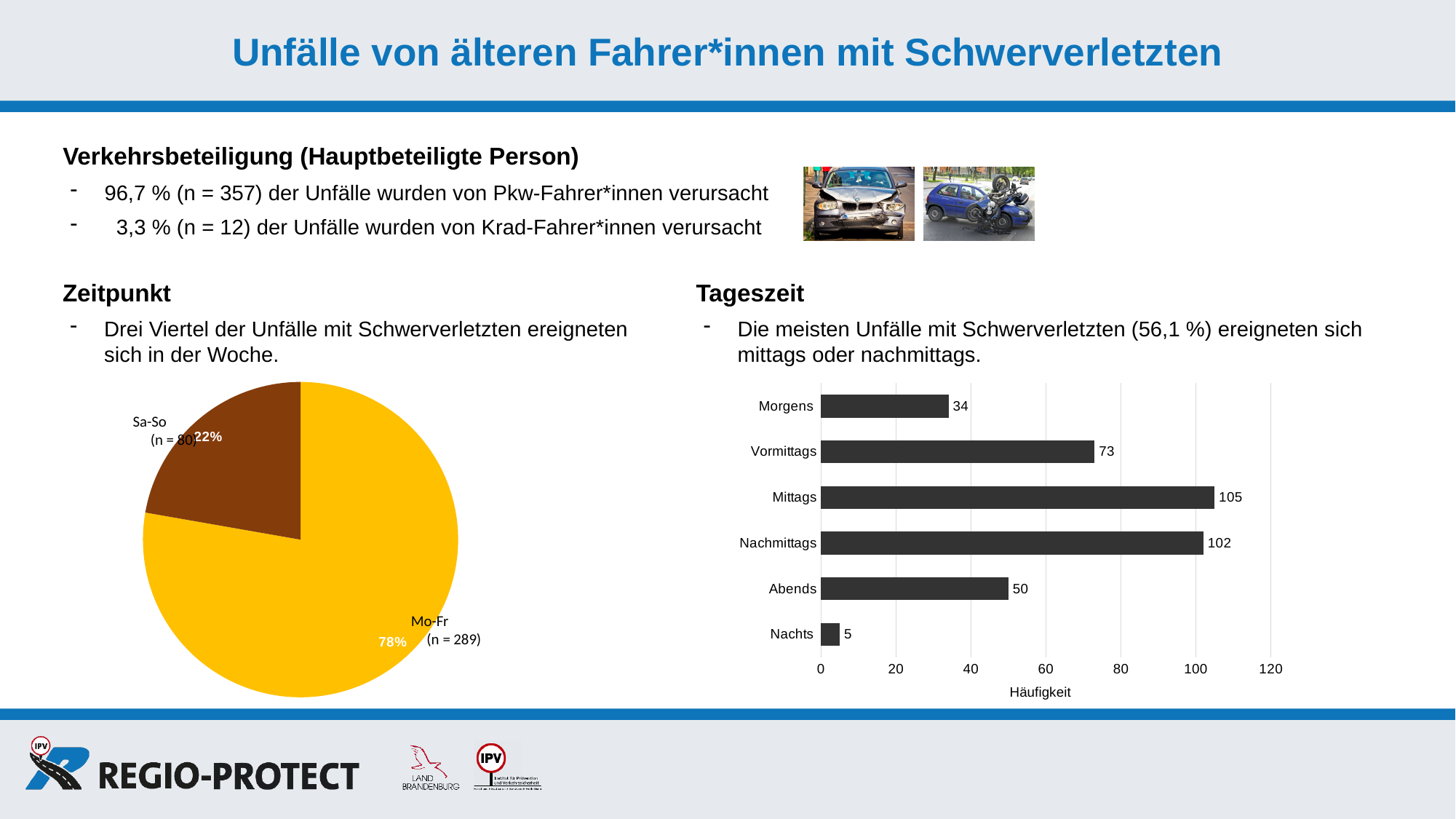
What is the x-axis label of the bar chart on the right (Tageszeit)? Häufigkeit How many categories are shown in the bar chart on the right (Tageszeit)? 6 In the bar chart on the right (Tageszeit), what is the value for Nachts? 5 In the pie chart on the left (Zeitpunkt), what share of accidents occurred Mo-Fr? 78% In the bar chart on the right (Tageszeit), which is larger, the value for Morgens or the value for Abends? Abends In the bar chart on the right (Tageszeit), what is the difference between the values for Nachmittags and Abends? 52 In the pie chart on the left (Zeitpunkt), what is the n value shown for Sa-So? n = 80 In the bar chart on the right (Tageszeit), what is the value for Vormittags? 73 What kind of chart is the chart on the right (Tageszeit)? Bar chart In the bar chart on the right (Tageszeit), which category has the highest value? Mittags In the bar chart on the right (Tageszeit), what is the value for Mittags? 105 In the bar chart on the right (Tageszeit), which category has the lowest value? Nachts